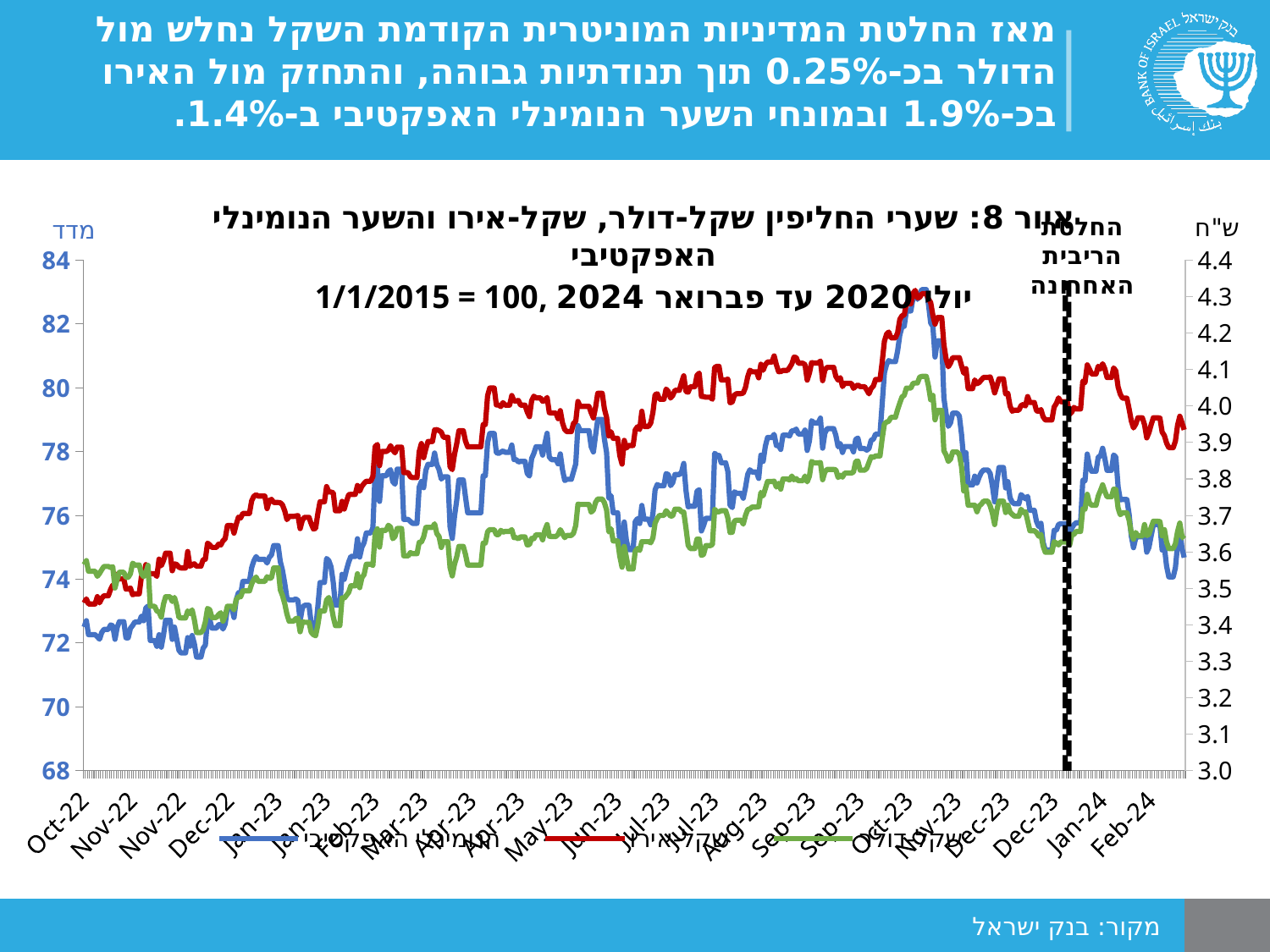
Is the peak of the green (שקל-דולר) line around Oct-23 greater or less than 4.0 on the right axis? greater Is the peak of the red (שקל-אירו) line around Oct-23 greater or less than 4.2 on the right axis? greater What is the figure number given in the chart title? איור 8 Is the red (שקל-אירו) line at Feb-24 greater or less than 3.8 on the right axis? greater What is the highest tick value shown on the left vertical axis? 84 What base value is stated in the chart subtitle for 1/1/2015? 100 What kind of chart is shown on the slide? line chart Does the red (שקל-אירו) line generally rise or fall from its Oct-23 peak to Feb-24? fall At Feb-24, which line is higher on the right axis: the red (שקל-אירו) or the green (שקל-דולר)? red (שקל-אירו) Does the blue (השער הנומינלי האפקטיבי) line generally rise or fall from Oct-22 to Oct-23? rise How many series does the chart's legend list? 3